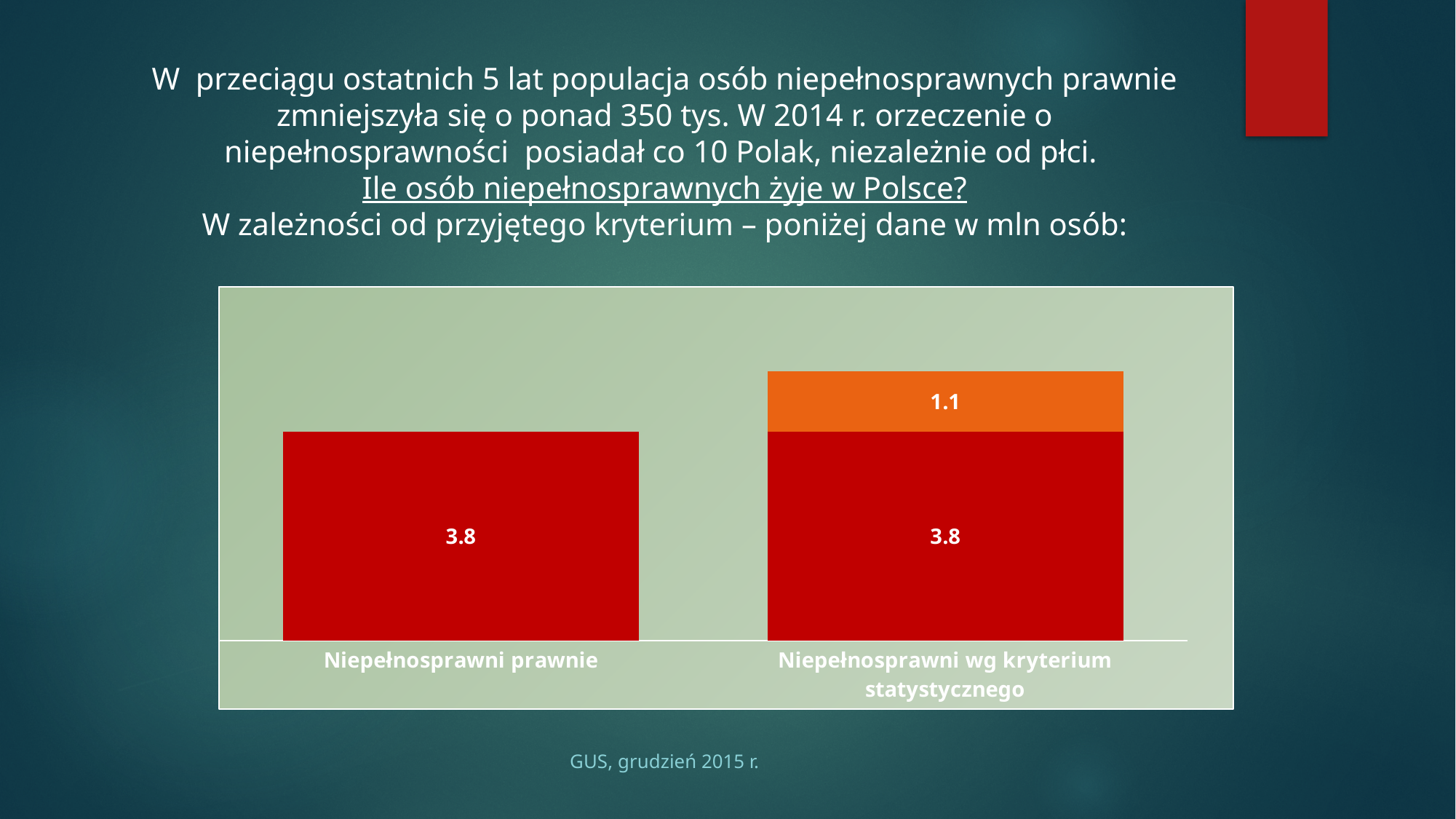
Which category has the taller bar overall? Niepełnosprawni wg kryterium statystycznego What is the value of the orange segment for "Niepełnosprawni wg kryterium statystycznego"? 1.1 What colour is the top segment of the bar for "Niepełnosprawni wg kryterium statystycznego"? Orange What is the value of the red segment for "Niepełnosprawni wg kryterium statystycznego"? 3.8 Is the total bar for "Niepełnosprawni wg kryterium statystycznego" larger or smaller than the bar for "Niepełnosprawni prawnie"? larger What source is cited below the chart? GUS, grudzień 2015 r. How many categories are shown on the x axis of the chart? 2 Which category has the shorter bar overall? Niepełnosprawni prawnie What kind of chart is shown on the slide? Stacked bar chart What is the total of the stacked bar for "Niepełnosprawni wg kryterium statystycznego"? 4.9 What is the difference between the total for "Niepełnosprawni wg kryterium statystycznego" and the value for "Niepełnosprawni prawnie"? 1.1 What is the value of the red segment for "Niepełnosprawni prawnie"? 3.8